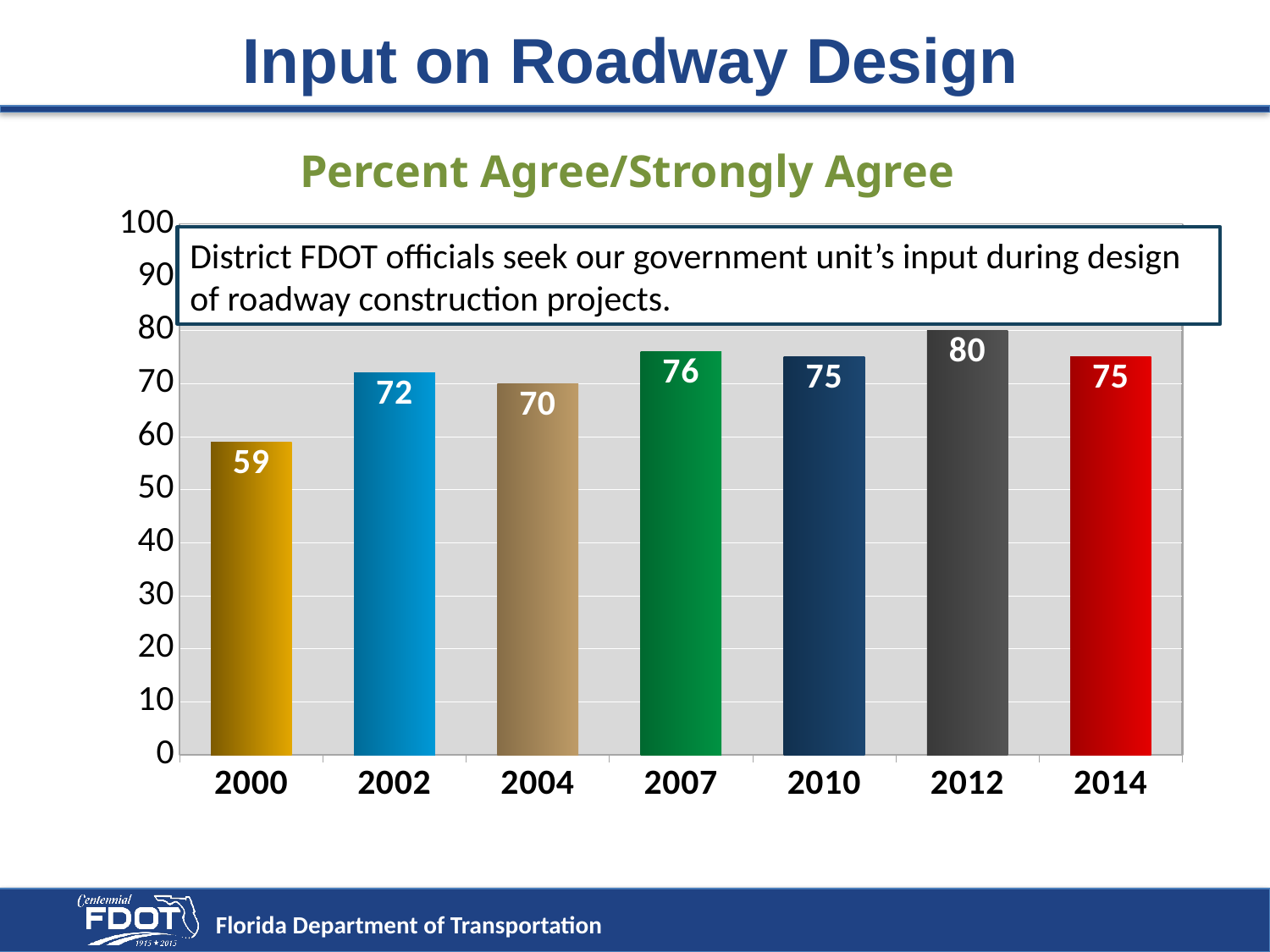
What is the value for 2012? 80 What is the value for 2000? 59 Which year has the lowest value? 2000 What is the title of the chart? Percent Agree/Strongly Agree Which is larger, the value for 2002 or the value for 2004? 2002 How many years are shown on the x axis? 7 Do the values rise or fall from 2000 to 2002? rise What is the value for 2004? 70 What kind of chart is shown? bar chart Which year has the highest value? 2012 What is the difference between the values for 2012 and 2000? 21 Is the value for 2007 greater or less than 70? greater